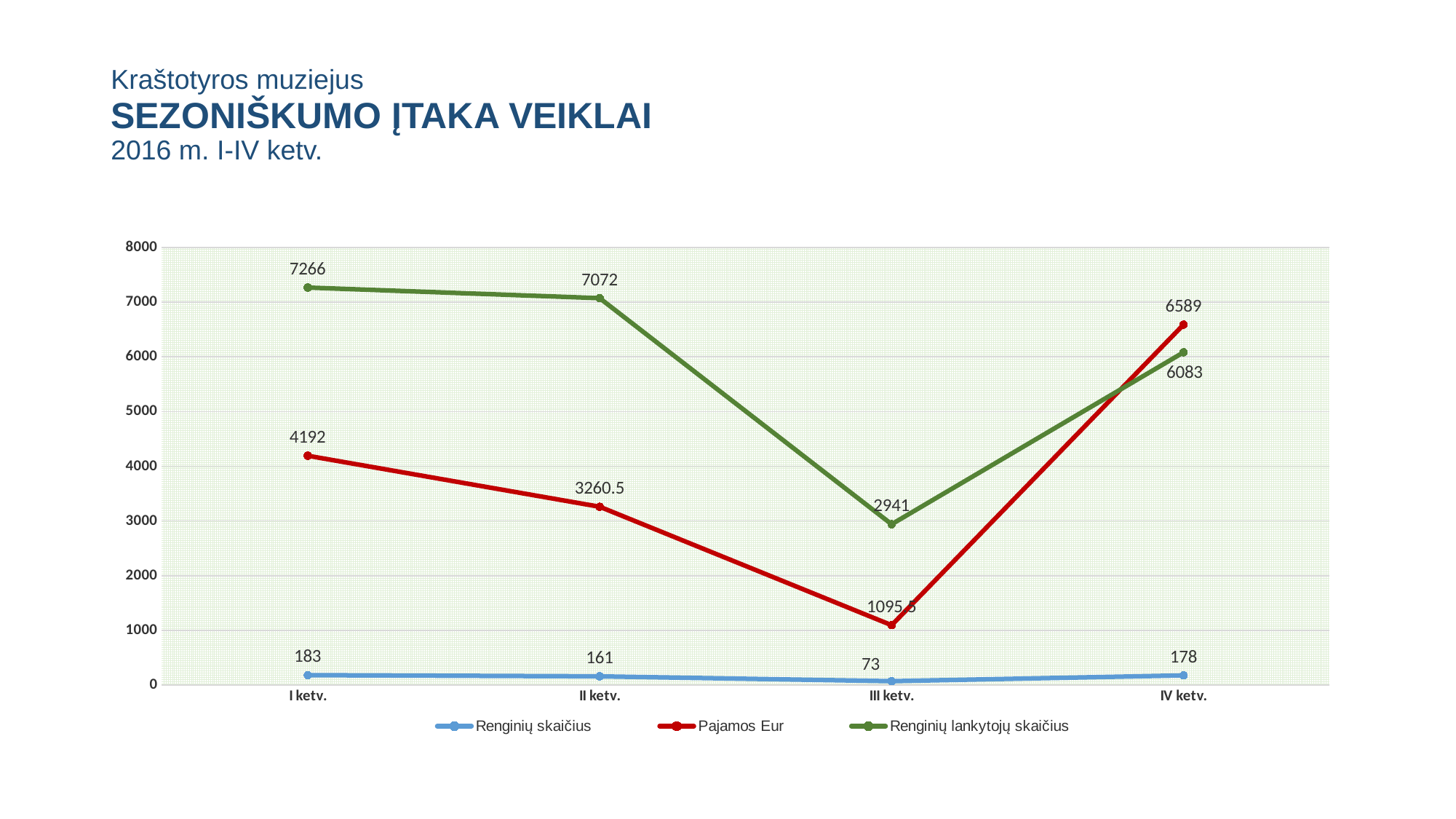
What is the difference between Renginių lankytojų skaičius in I ketv. and II ketv.? 194 Does Pajamos Eur rise or fall from I ketv. to III ketv.? fall What is the value of Renginių lankytojų skaičius for I ketv.? 7266 How many quarters (categories) are plotted on the x axis? 4 Which is larger in IV ketv.: Pajamos Eur or Renginių lankytojų skaičius? Pajamos Eur What is the value of Renginių skaičius for IV ketv.? 178 In which quarter is Pajamos Eur highest? IV ketv. In which quarter is Renginių lankytojų skaičius lowest? III ketv. What is the value of Pajamos Eur for III ketv.? 1095.5 What type of chart is shown on the slide? line chart Which series is drawn in red? Pajamos Eur How many series does the legend list? 3